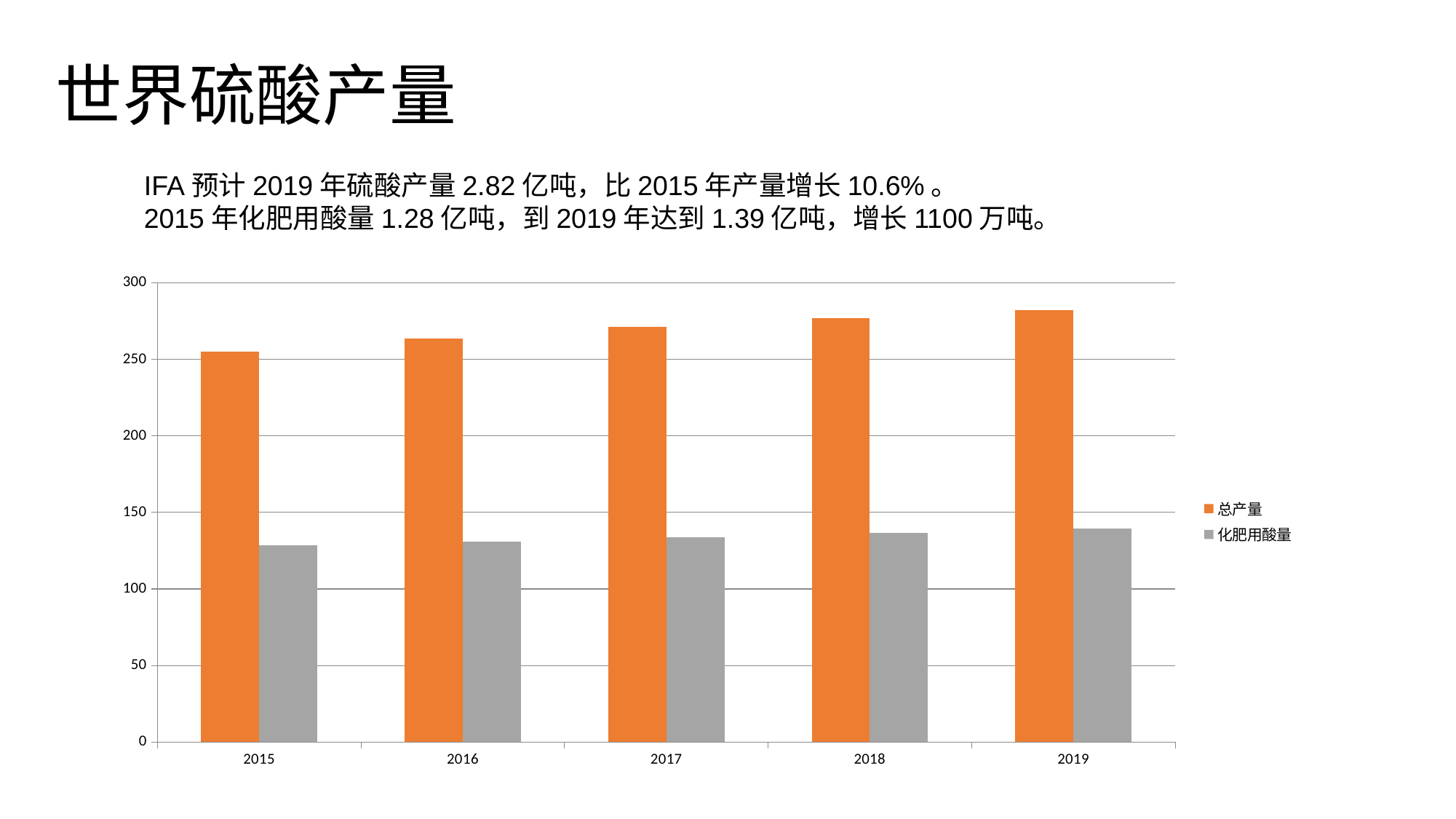
How many years are shown along the x axis of the chart? 5 What colour are the 总产量 bars in the chart? orange In which year is the 总产量 bar the highest? 2019 What kind of chart is shown on the slide? bar chart Do the 总产量 values rise or fall from 2015 to 2019? rise Is the 化肥用酸量 value for 2019 greater or less than 150? less In which year is the 化肥用酸量 bar the lowest? 2015 Is the 总产量 value for 2017 greater or less than 250? greater Is the 总产量 value for 2019 greater or less than 300? less In which year is the 总产量 bar the lowest? 2015 In 2018, which is larger: 总产量 or 化肥用酸量? 总产量 How many series does the chart legend list? 2